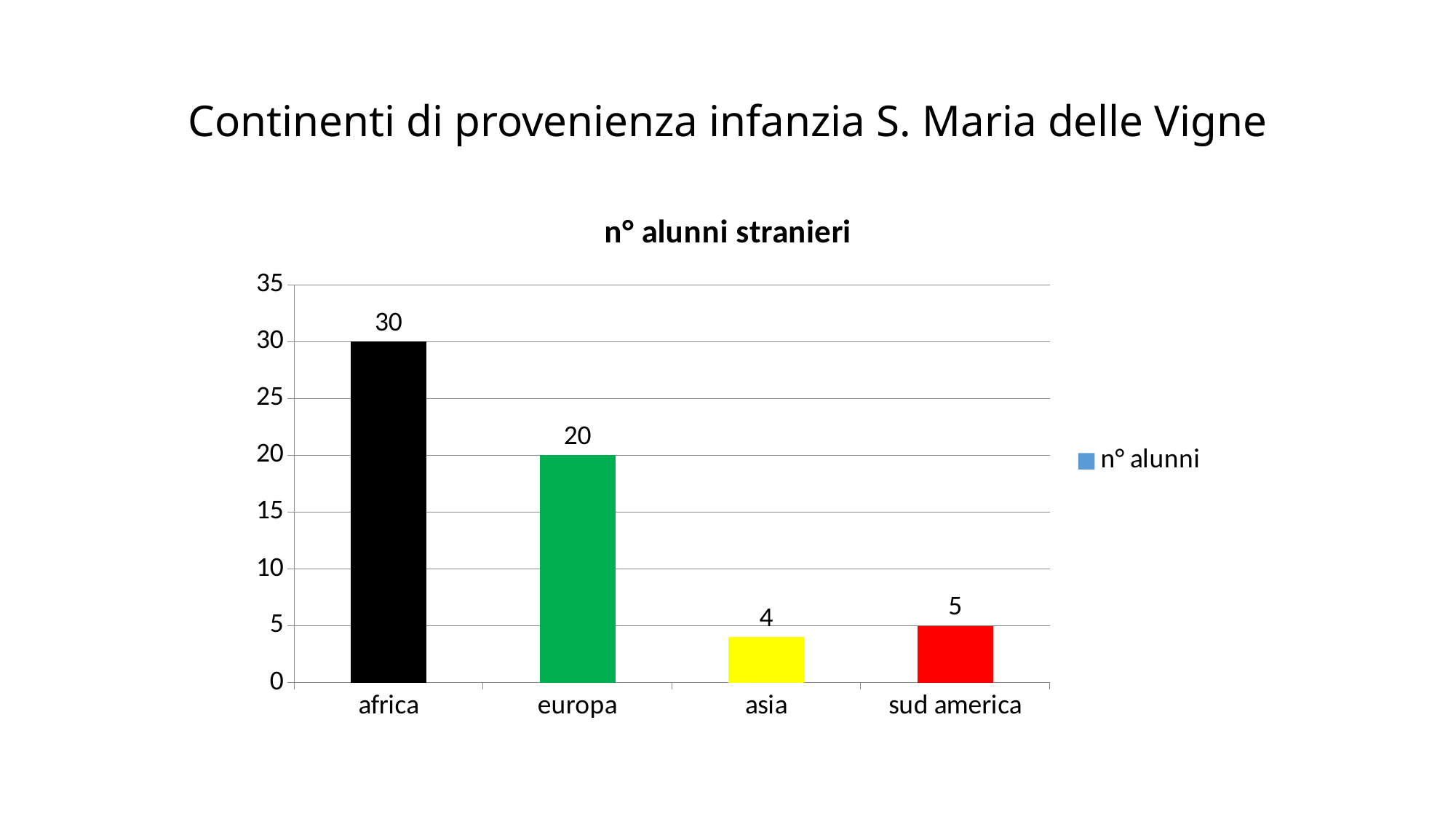
What is the difference between the values for africa and europa? 10 What is the value for asia? 4 What is the title of the chart? n° alunni stranieri What kind of chart is shown? bar chart Which category has the highest value? africa What is the value for africa? 30 Which category has the lowest value? asia Is the value for europa greater or less than 25? less What is the value for sud america? 5 Which is larger, the value for sud america or the value for asia? sud america How many categories are shown on the x axis? 4 What is the value for europa? 20